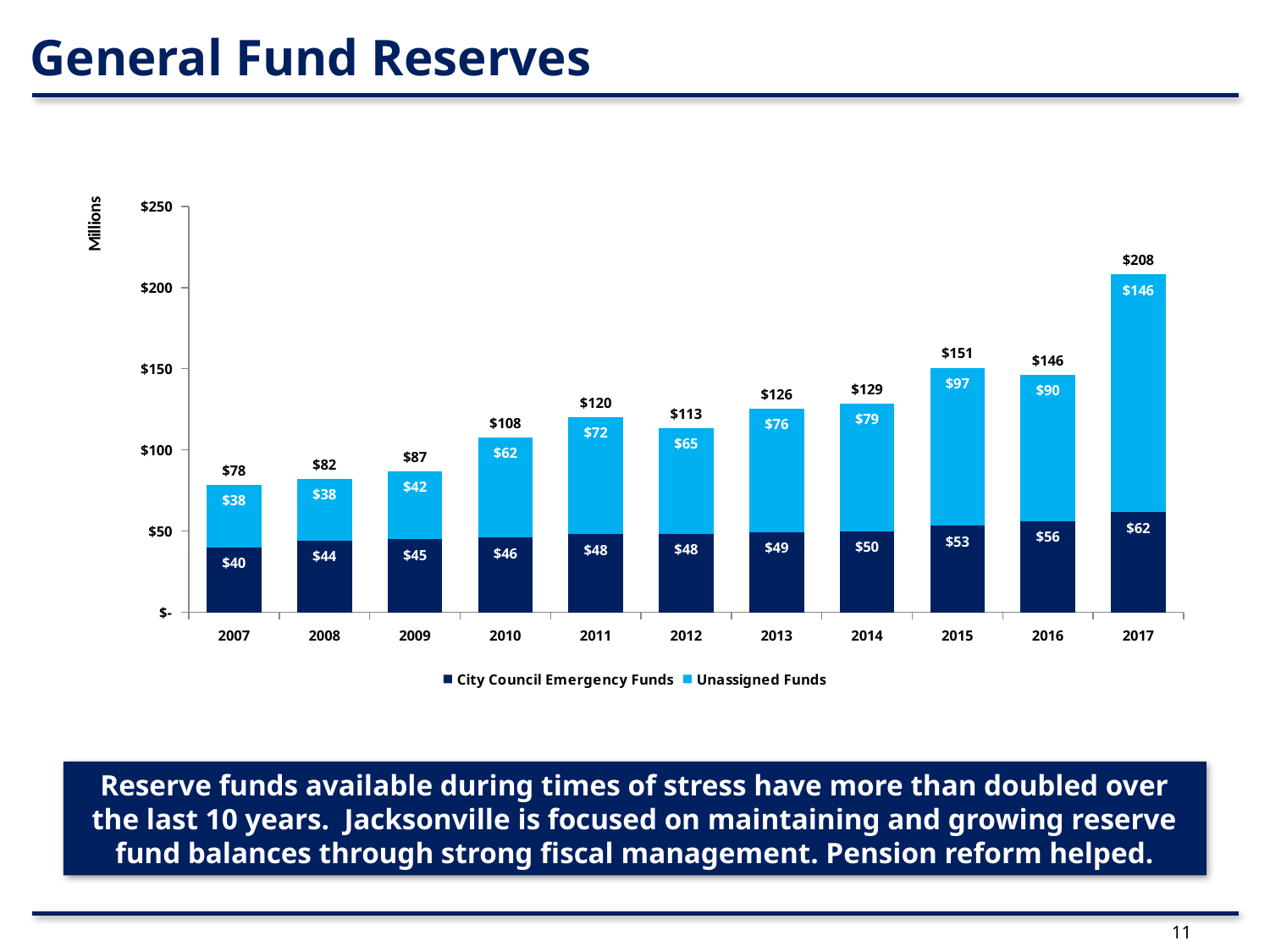
Which year has the lowest total General Fund Reserves? 2007 What is the difference between the total reserves in 2017 and 2016? $62 How many series does the legend list? 2 What kind of chart is shown on the slide? Stacked bar chart What is the value of City Council Emergency Funds in 2010? $46 Which is larger, Unassigned Funds in 2015 or Unassigned Funds in 2016? Unassigned Funds in 2015 Is the total reserves value for 2014 greater or less than $100? greater Do the total General Fund Reserves generally rise or fall from 2007 to 2017? Rise How many years are shown on the x axis? 11 What is the total General Fund Reserves for 2013? $126 Which year has the highest total General Fund Reserves? 2017 What is the value of Unassigned Funds in 2017? $146